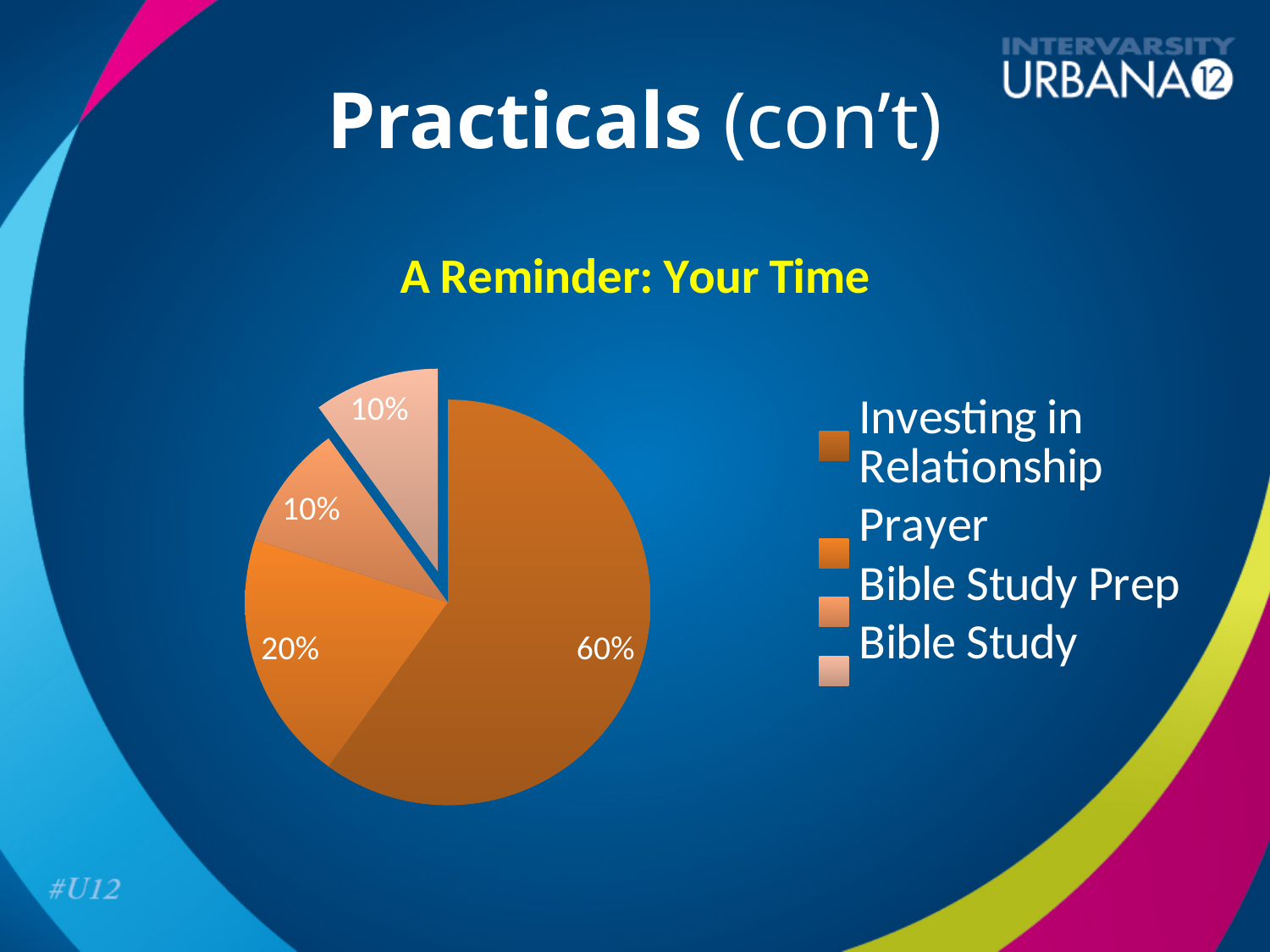
What kind of chart is shown on the slide? pie chart What share of the pie is labelled for Prayer? 20% What share of the pie is labelled for Investing in Relationship? 60% What is the combined share of Bible Study Prep and Bible Study? 20% What is the difference between the shares for Investing in Relationship and Prayer? 40% Which is larger, the share for Prayer or the share for Bible Study Prep? Prayer How many entries does the legend list? 4 What is the title shown above the pie chart? A Reminder: Your Time What share of the pie is labelled for Bible Study? 10% Which category takes the largest slice of the pie? Investing in Relationship What share of the pie is labelled for Bible Study Prep? 10% How many slices does the pie chart have? 4